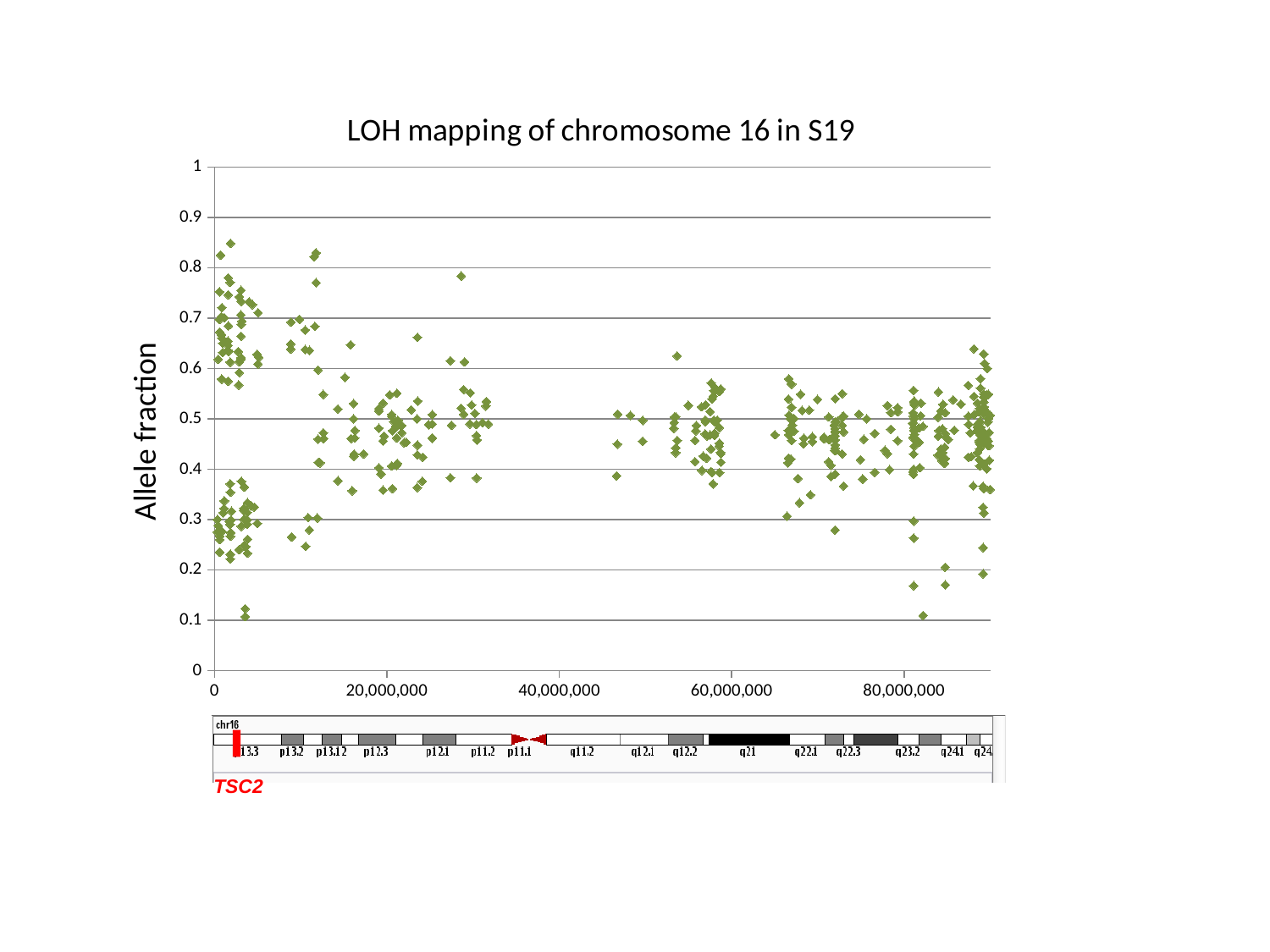
Are the allele fraction values for points near 60,000,000 on the x axis greater or less than 0.7? less What kind of chart is shown on the slide? Scatter plot What is the largest tick label shown on the x axis? 80,000,000 What is the maximum value shown on the y axis? 1 Is the lowest plotted allele fraction greater or less than 0.2? less Is the highest plotted allele fraction greater or less than 0.9? less What is the label of the y axis? Allele fraction What is the title of the chart? LOH mapping of chromosome 16 in S19